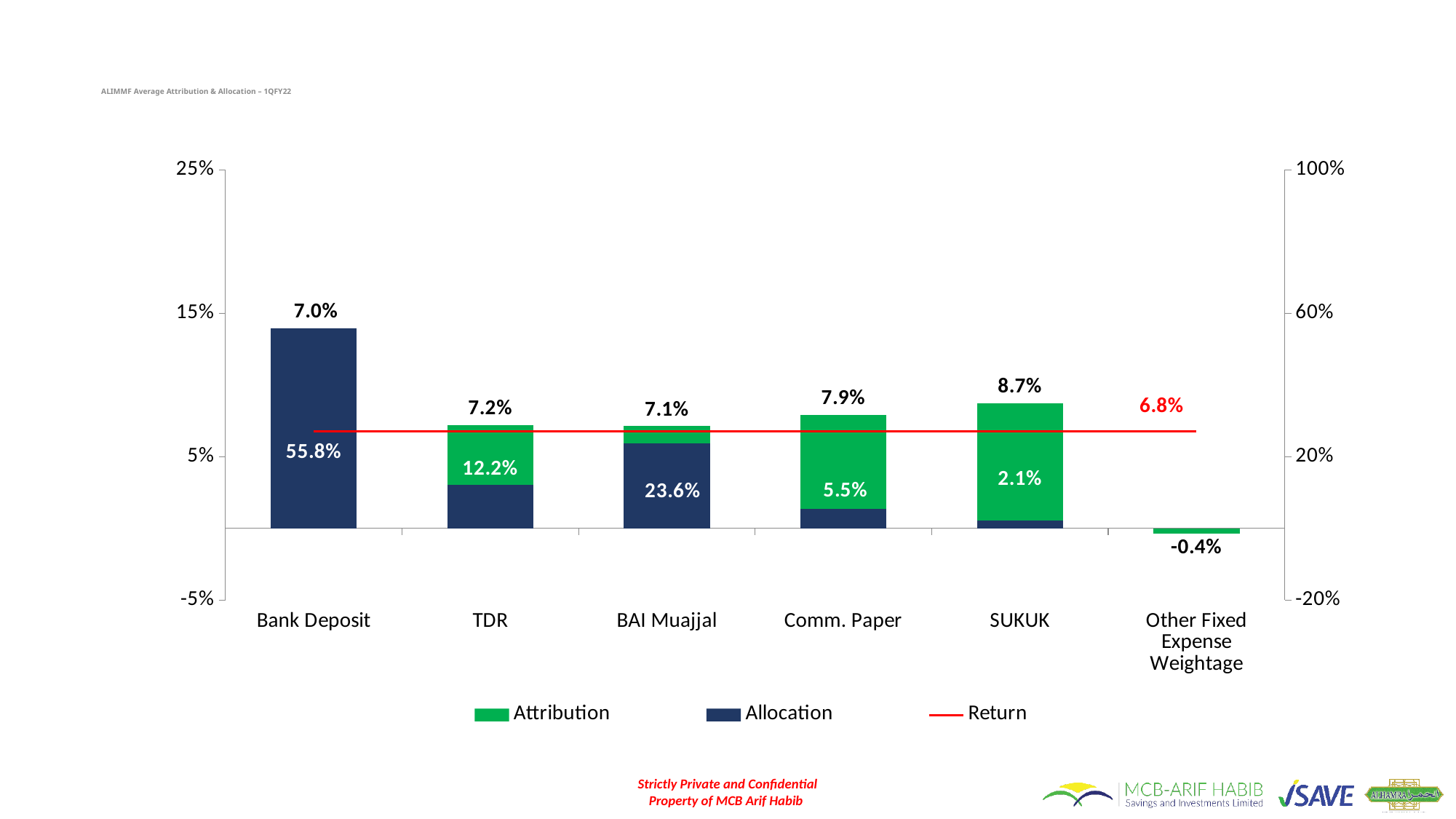
What is the Allocation value for BAI Muajjal? 23.6% Which category has the highest Attribution value? SUKUK What is the Attribution value for Other Fixed Expense Weightage? -0.4% What is the Attribution value for SUKUK? 8.7% How many series does the legend list? 3 How many categories are shown on the x axis? 6 Which category has the lowest Allocation value among those labelled? SUKUK Which has a larger Allocation value, TDR or BAI Muajjal? BAI Muajjal What is the title of the chart? ALIMMF Average Attribution & Allocation – 1QFY22 What is the difference between the Attribution values for SUKUK and Bank Deposit? 1.7% What value is labelled on the Return line? 6.8% What is the Allocation value for Bank Deposit? 55.8%